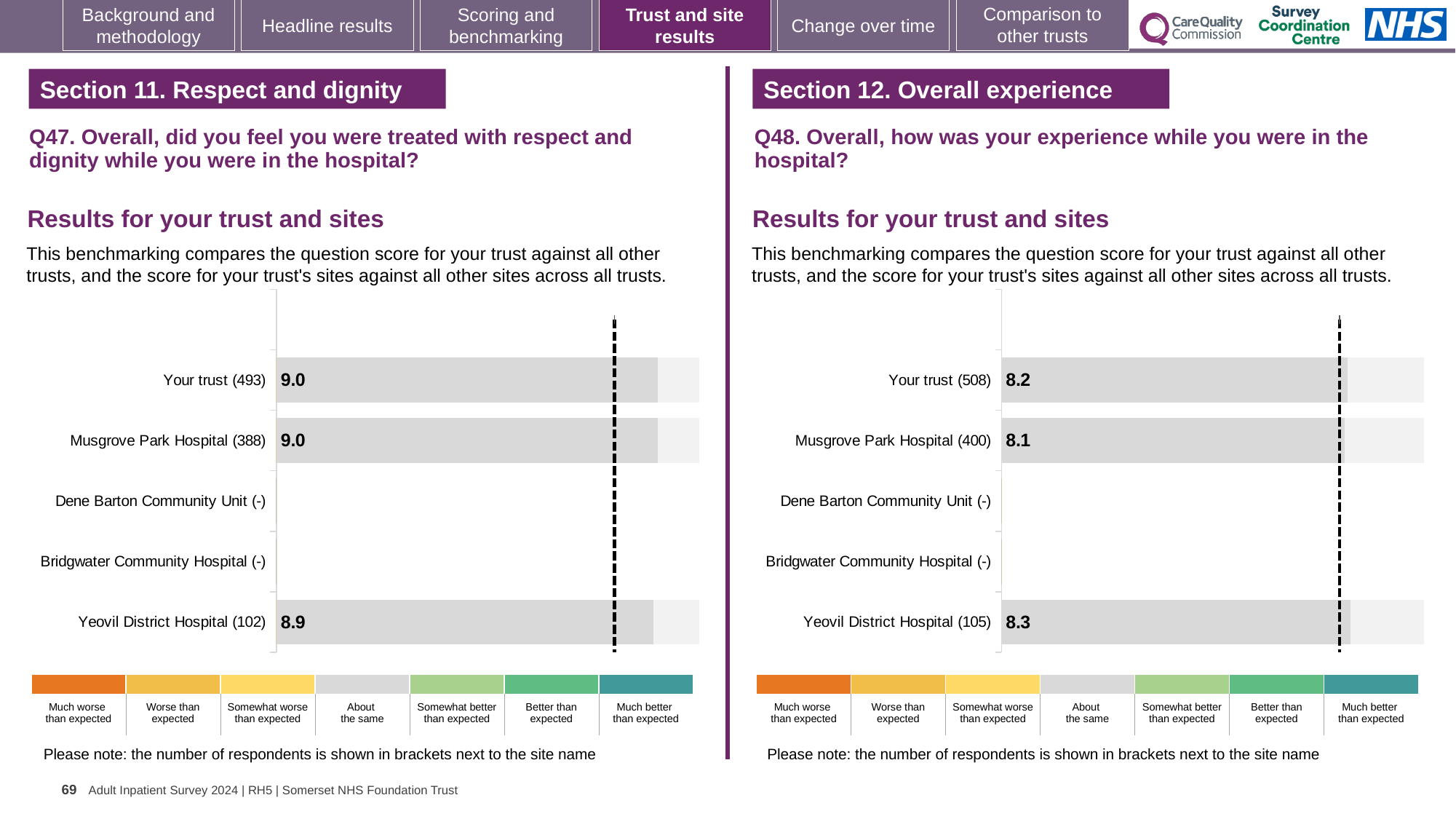
In the Q47 chart on the left, what is the score for Yeovil District Hospital? 8.9 In the Q48 chart on the right, which site has the lowest score? Musgrove Park Hospital In the Q48 chart on the right, what is the score for Your trust? 8.2 In the Q48 chart on the right, which has the larger score, Yeovil District Hospital or Musgrove Park Hospital? Yeovil District Hospital In the Q47 chart on the left, how many respondents are shown in brackets for Musgrove Park Hospital? 388 What type of chart is used for the Q48 results on the right? Bar chart In the Q48 chart on the right, what is the score for Musgrove Park Hospital? 8.1 In the Q47 chart on the left, what is the score for Your trust? 9.0 In the Q48 chart on the right, which site has the highest score? Yeovil District Hospital In the Q47 chart on the left, what is the difference between the scores for Musgrove Park Hospital and Yeovil District Hospital? 0.1 In the Q48 chart on the right, what is the difference between the scores for Yeovil District Hospital and Your trust? 0.1 How many rows (trust and sites) are listed in the Q47 chart on the left? 5